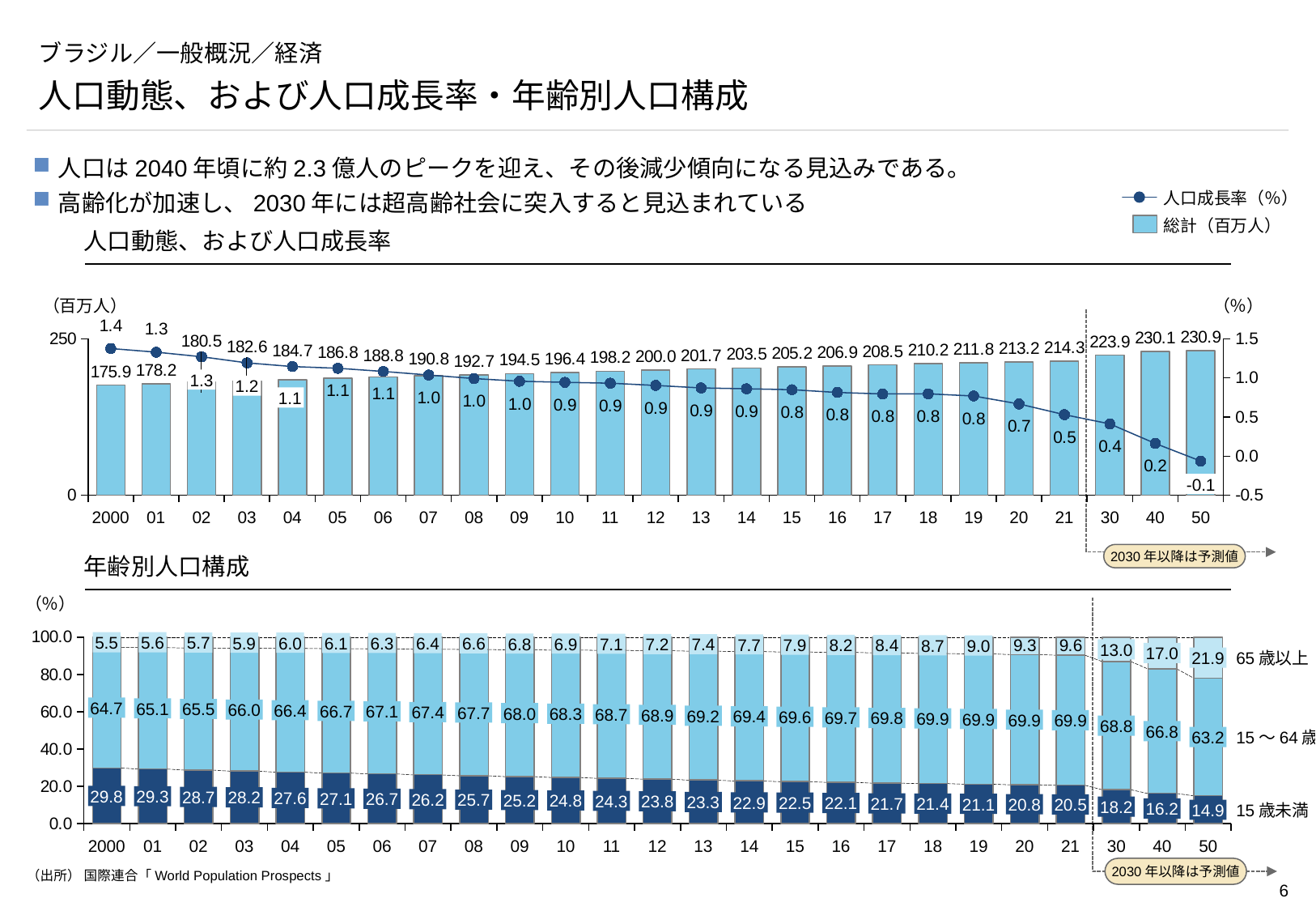
In the chart titled 年齢別人口構成, which is larger: the 15～64歳 value for 2000 or for 50 (2050)? 2000 In the chart titled 人口動態、および人口成長率, which year has the highest 総計（百万人） value? 50 (2050) In the chart titled 年齢別人口構成, what is the 15歳未満 value for 50 (2050)? 14.9 What kind of chart is the chart titled 年齢別人口構成? stacked bar chart In the chart titled 年齢別人口構成, what is the difference between the 65歳以上 values for 50 (2050) and 2000? 16.4 In the chart titled 年齢別人口構成, what is the 65歳以上 value for 2000? 5.5 In the chart titled 人口動態、および人口成長率, how many series does the legend list? 2 In the chart titled 人口動態、および人口成長率, which year has the lowest 人口成長率（%） value? 50 (2050) In the chart titled 人口動態、および人口成長率, what is the 総計（百万人） value for 2000? 175.9 In the chart titled 人口動態、および人口成長率, what is the difference between the 総計 values for 50 (2050) and 2000? 55.0 In the chart titled 人口動態、および人口成長率, what is the 人口成長率（%） value for 50 (2050)? -0.1 In the chart titled 人口動態、および人口成長率, does the 人口成長率（%） line rise or fall from 2000 to 50 (2050)? fall